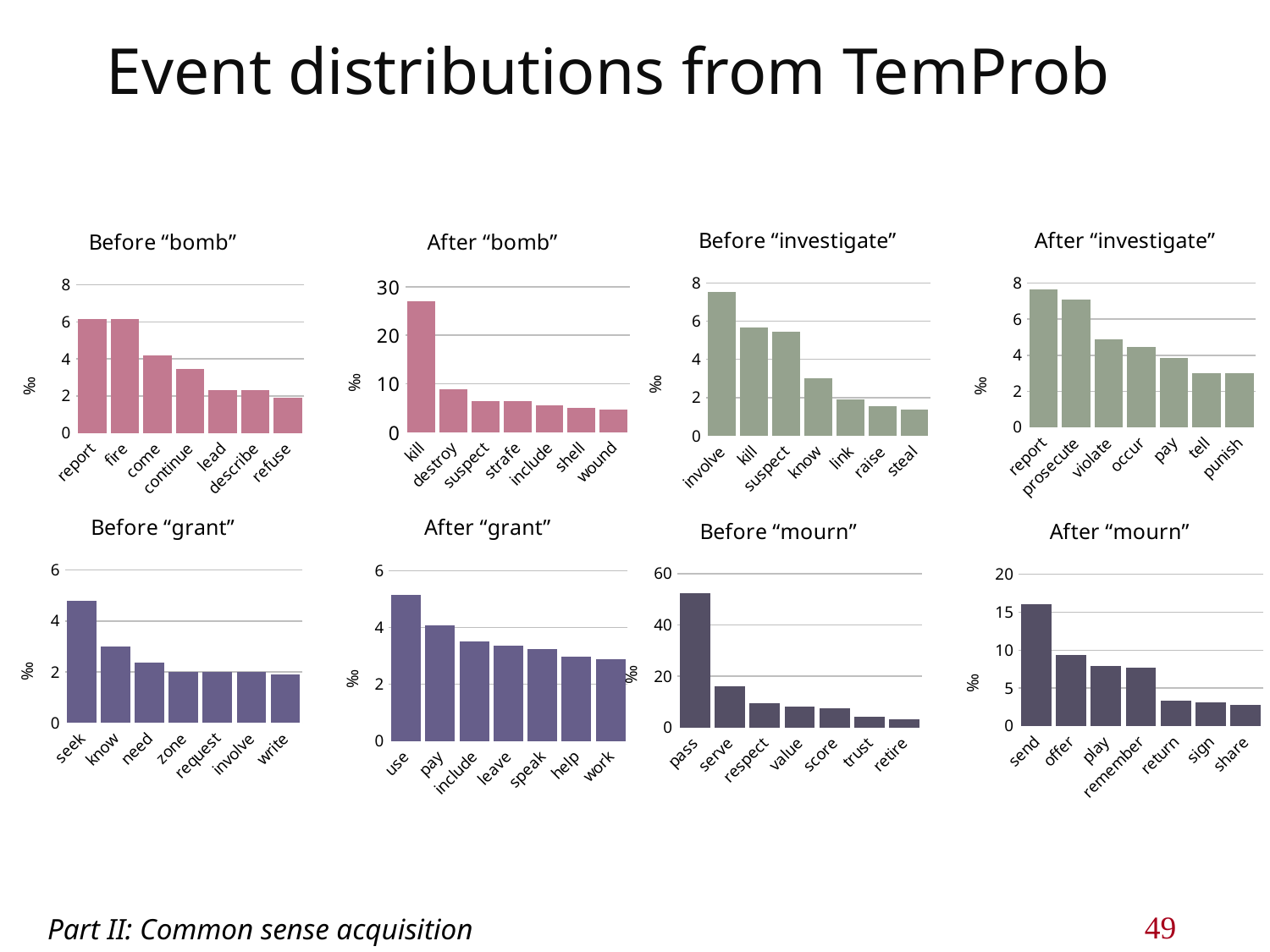
In the "Before "investigate"" chart, which category has the highest value? involve In the "After "bomb"" chart, which category has the highest value? kill In the "Before "grant"" chart, which category has the highest value? seek In the "Before "mourn"" chart, is the value for pass greater or less than 40? greater How many categories are shown in the "After "investigate"" chart? 7 In the "After "grant"" chart, is the value for use greater or less than 4? greater What kind of chart is the "Before "bomb"" chart? bar chart In the "Before "bomb"" chart, do the values rise or fall from left to right along the x axis? fall In the "Before "investigate"" chart, which is larger, the value for involve or the value for know? involve What unit is shown on the y axis of the "After "mourn"" chart? ‰ In the "After "bomb"" chart, is the value for kill greater or less than 20? greater